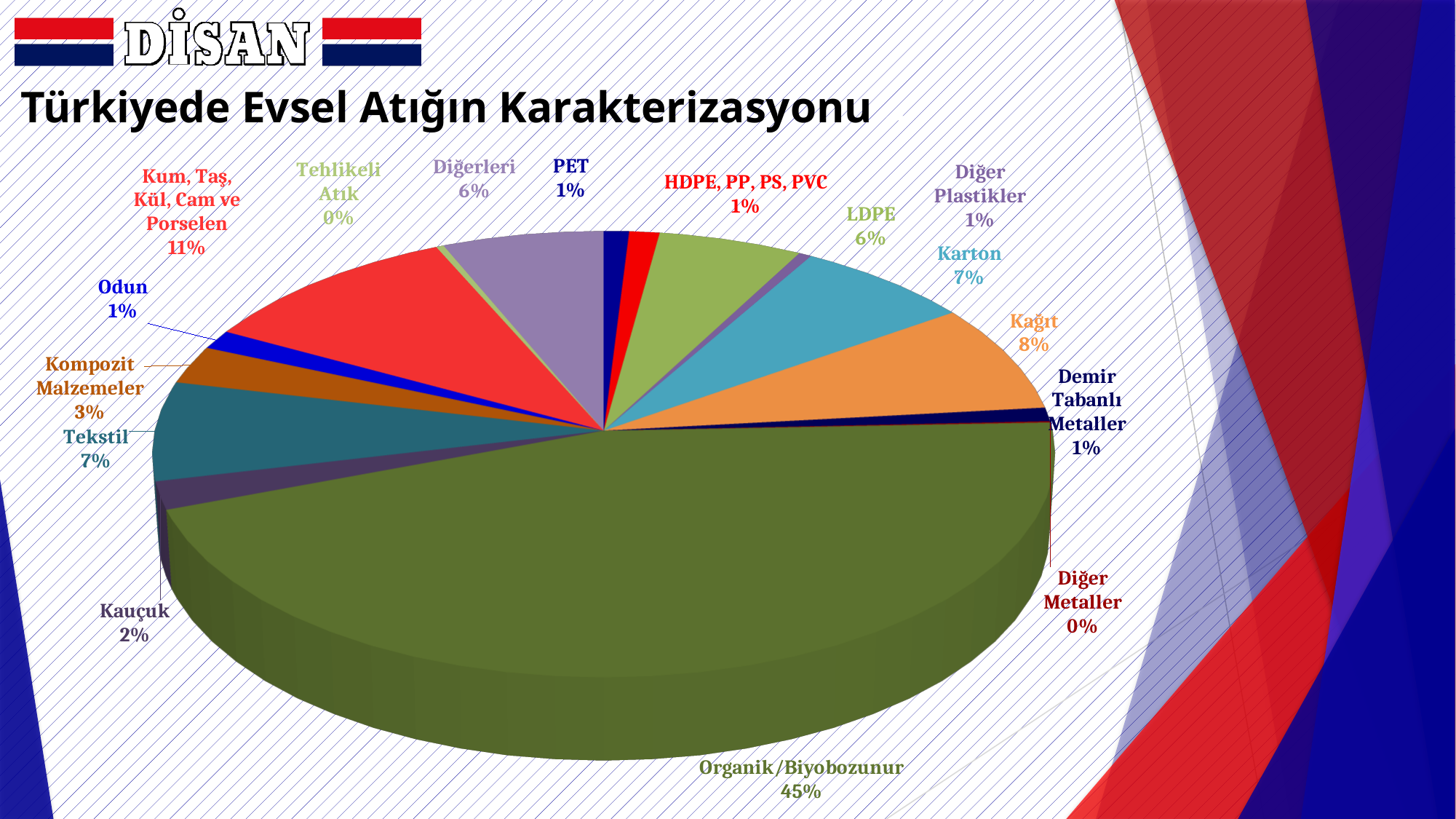
What is the title of the chart? Türkiyede Evsel Atığın Karakterizasyonu What is the value shown for Kompozit Malzemeler? 3% How many categories are shown in the pie chart? 16 Which category has the largest share of the pie? Organik/Biyobozunur What is the value shown for Kum, Taş, Kül, Cam ve Porselen? 11% What is the difference between the shares of Organik/Biyobozunur and Kum, Taş, Kül, Cam ve Porselen? 34% What kind of chart is shown on the slide? Pie chart Which is larger, the share for Kağıt or the share for LDPE? Kağıt What is the value shown for Kağıt? 8% What is the difference between the shares of Karton and Kompozit Malzemeler? 4% What share of the pie does Organik/Biyobozunur have? 45% What is the value shown for Kauçuk? 2%